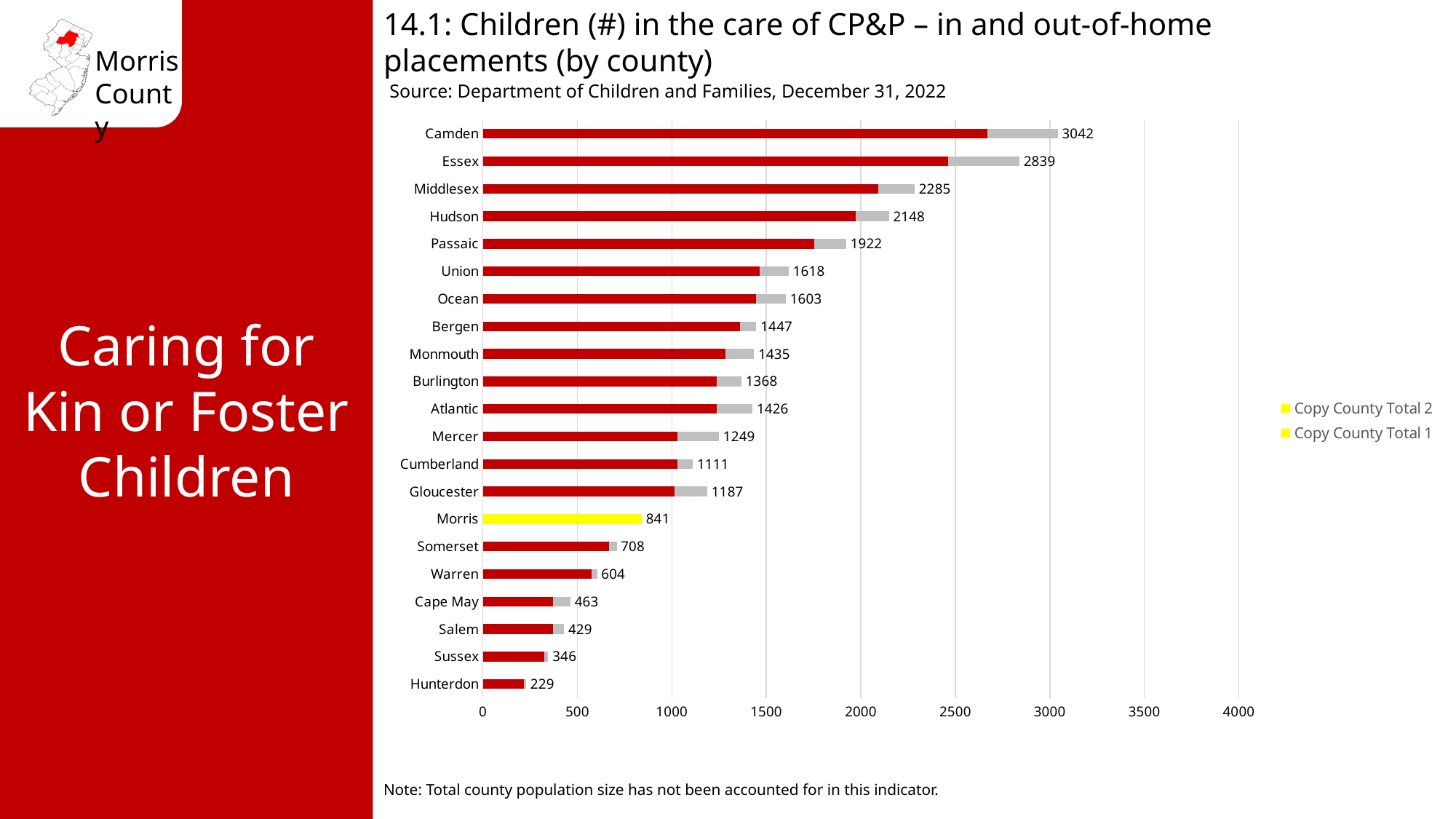
Which county has a larger total, Atlantic or Burlington? Atlantic Which county has a larger total, Gloucester or Cumberland? Gloucester What is the value shown for Morris county? 841 What is the value shown for Hunterdon county? 229 What is the total number of children in the care of CP&P for Camden county? 3042 What is the difference between the totals for Morris and Somerset? 133 How many counties are shown in the chart? 21 Which county has the highest total number of children in the care of CP&P? Camden What kind of chart is shown on the slide? Bar chart Which county has the lowest total number of children in the care of CP&P? Hunterdon What is the difference between the totals for Camden and Essex? 203 How many series does the legend list? 2